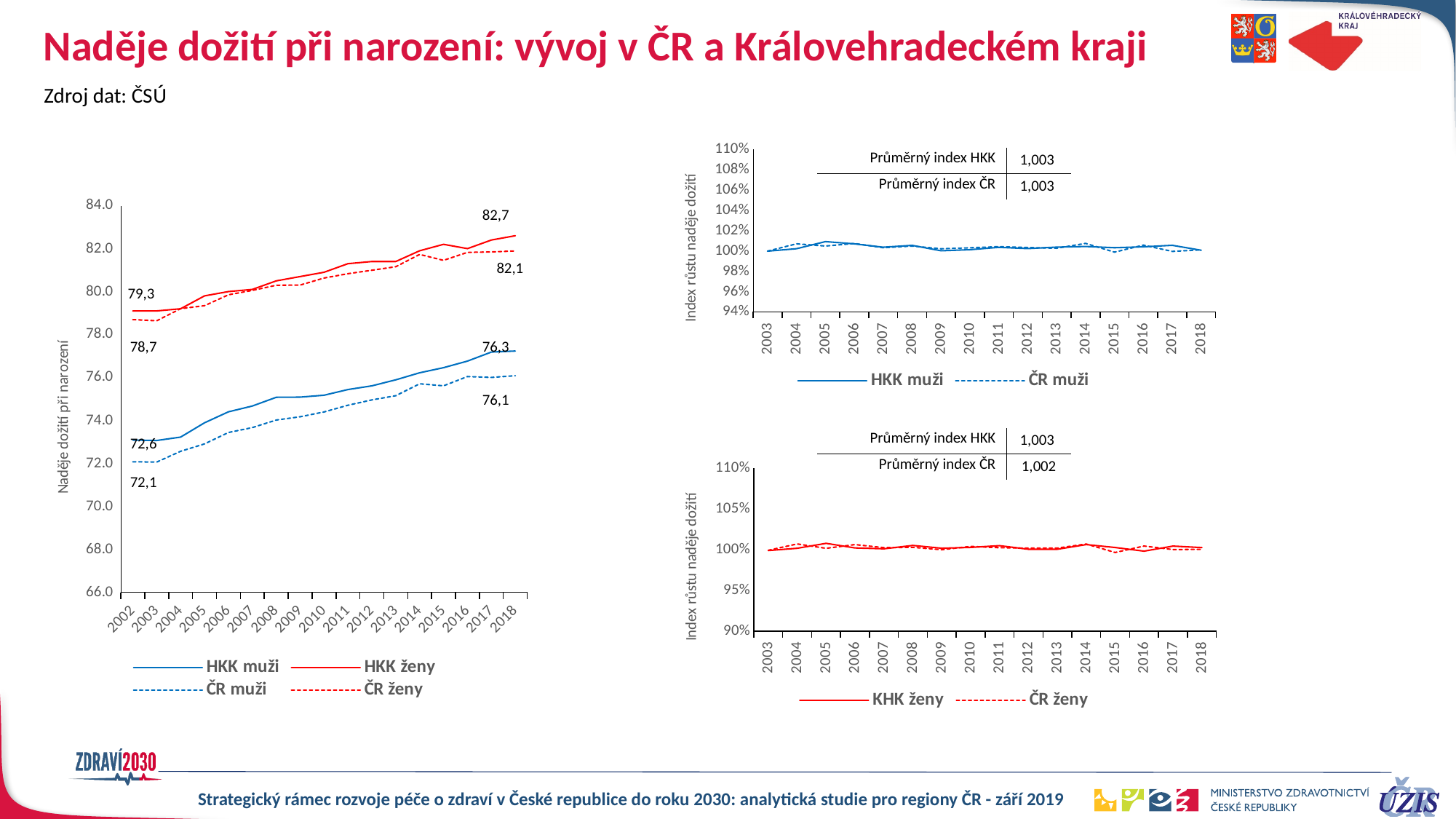
In the left chart, what is the value for HKK muži in 2002? 72,6 In the left chart, is the value for HKK ženy in 2010 greater or less than 80.0? greater In the bottom-right chart (KHK ženy / ČR ženy), what is the Průměrný index ČR? 1,002 In the top-right chart (HKK muži / ČR muži), what is the Průměrný index ČR? 1,003 How many series does the legend of the left chart list? 4 In the left chart, what is the value for ČR muži in 2018? 76,1 What kind of chart is the left chart? Line chart In the left chart, what is the difference between HKK ženy and ČR ženy in 2018? 0,6 In the left chart, which is larger in 2018: HKK muži or ČR muži? HKK muži In the left chart, do the values for HKK muži rise or fall from 2002 to 2018? Rise In the left chart (Naděje dožití při narození), what is the value for HKK ženy in 2018? 82,7 How many series does the legend of the bottom-right chart list? 2